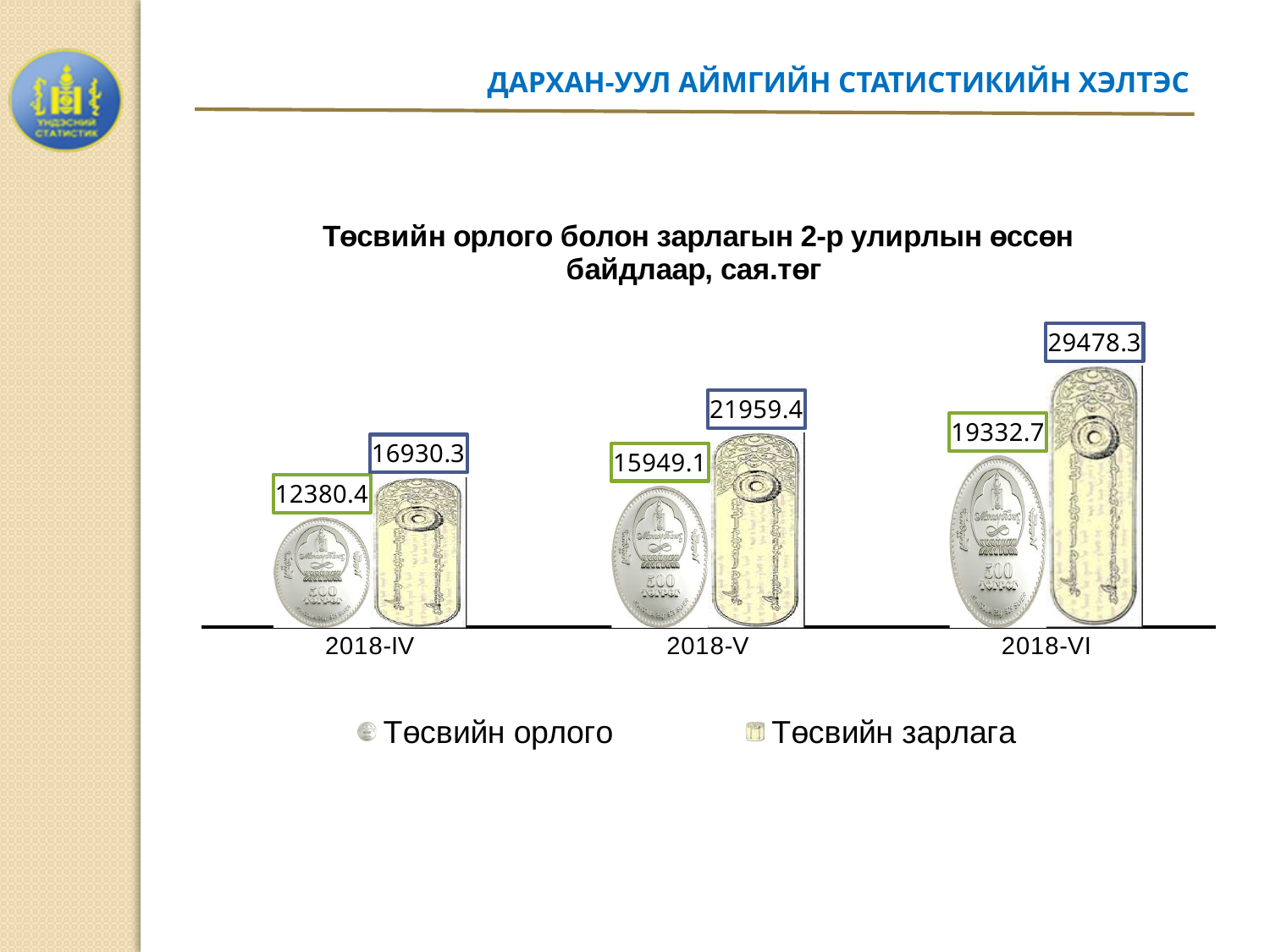
What is the difference between Төсвийн зарлага and Төсвийн орлого for 2018-VI? 10145.6 Which category has the highest value for Төсвийн зарлага? 2018-VI Which is larger for 2018-V: Төсвийн орлого or Төсвийн зарлага? Төсвийн зарлага Which category has the lowest value for Төсвийн орлого? 2018-IV What is the value of Төсвийн орлого for 2018-VI? 19332.7 What is the value of Төсвийн зарлага for 2018-VI? 29478.3 How many categories are shown on the x axis? 3 What is the value of Төсвийн орлого for 2018-IV? 12380.4 Do the values for Төсвийн орлого rise or fall from 2018-IV to 2018-VI? rise What is the value of Төсвийн зарлага for 2018-V? 21959.4 How many series does the legend list? 2 What is the difference between Төсвийн зарлага and Төсвийн орлого for 2018-IV? 4549.9